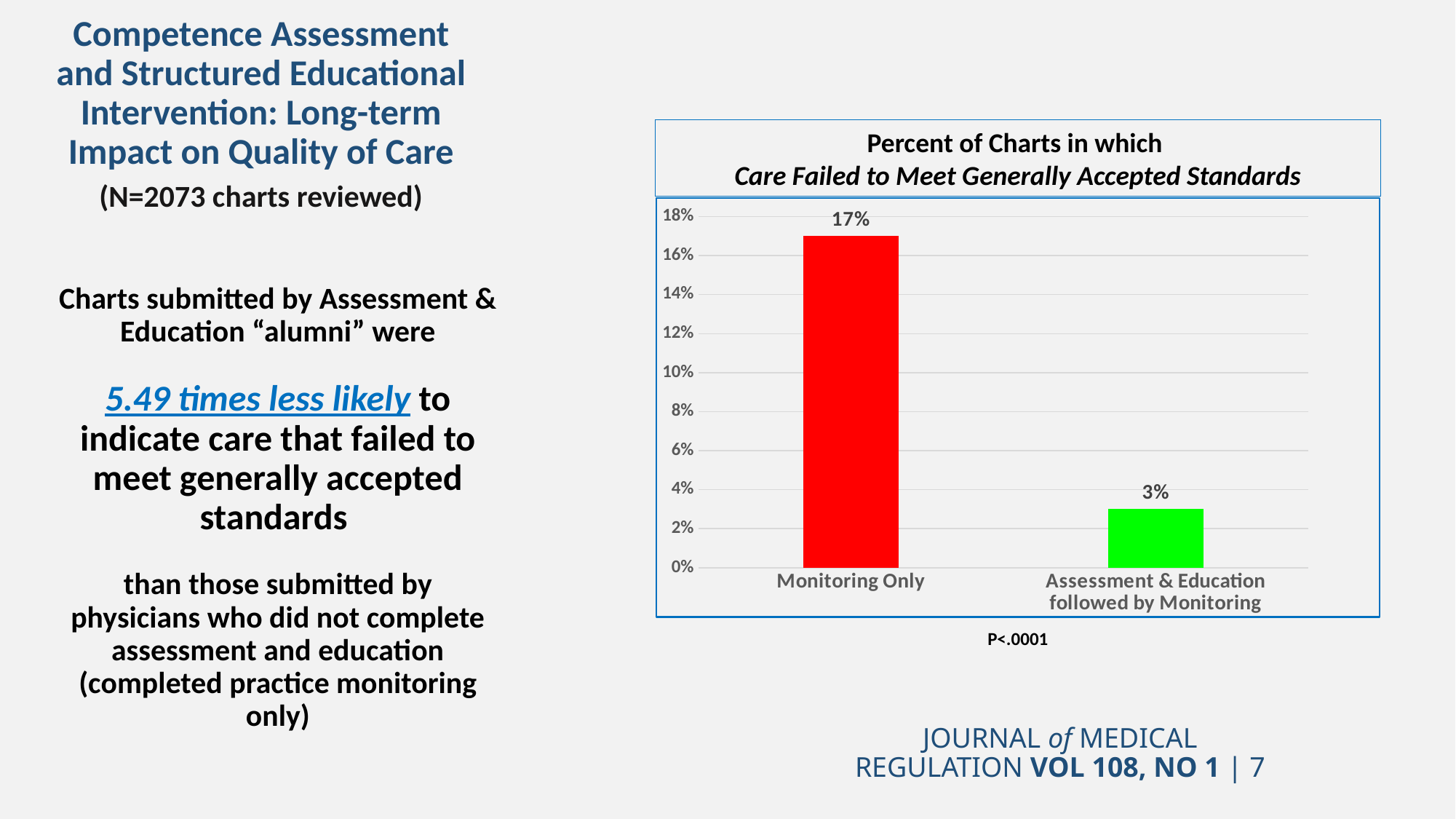
Which is larger, the value for Monitoring Only or the value for Assessment & Education followed by Monitoring? Monitoring Only What is the difference between the values for Monitoring Only and Assessment & Education followed by Monitoring? 14% What is the value for Assessment & Education followed by Monitoring? 3% What is the value for Monitoring Only? 17% Is the value for Monitoring Only greater or less than 10%? greater What is the title of the chart? Percent of Charts in which Care Failed to Meet Generally Accepted Standards Which category has the lowest percent of charts in which care failed to meet generally accepted standards? Assessment & Education followed by Monitoring What kind of chart is shown on the slide? bar chart Which category has the highest percent of charts in which care failed to meet generally accepted standards? Monitoring Only What colour is the bar for Monitoring Only? red Is the value for Assessment & Education followed by Monitoring greater or less than 4%? less How many categories are shown in the chart? 2